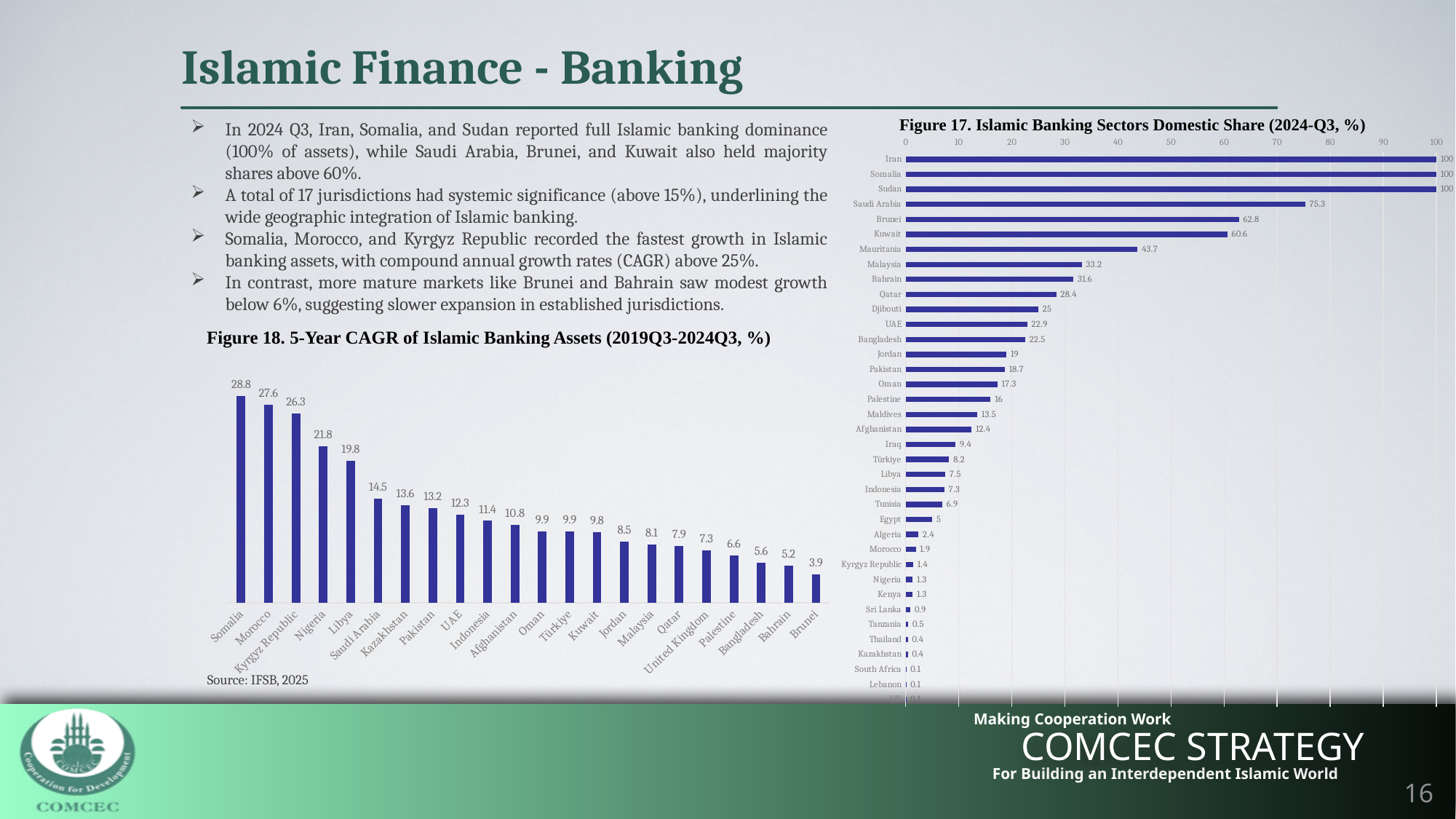
In Figure 17, is the value for Mauritania greater or less than 40? greater In Figure 18, what is the 5-year CAGR of Islamic banking assets for Somalia? 28.8 In Figure 17, what is the domestic share for Djibouti? 25 In Figure 18, which country has the lowest 5-year CAGR? Brunei In Figure 18, do the values rise or fall moving from left to right along the x axis? Fall In Figure 17, which is larger, the domestic share of Malaysia or Bahrain? Malaysia In Figure 17, what is the difference between the domestic shares of Brunei and Kuwait? 2.2 In Figure 18, how many countries are shown on the x axis? 22 In Figure 17, what is the Islamic banking domestic share for Saudi Arabia? 75.3 What is the title of the chart on the right side of the slide? Figure 17. Islamic Banking Sectors Domestic Share (2024-Q3, %) In Figure 18, what kind of chart is used? Bar chart In Figure 18, what is the difference between the CAGR of Morocco and Nigeria? 5.8